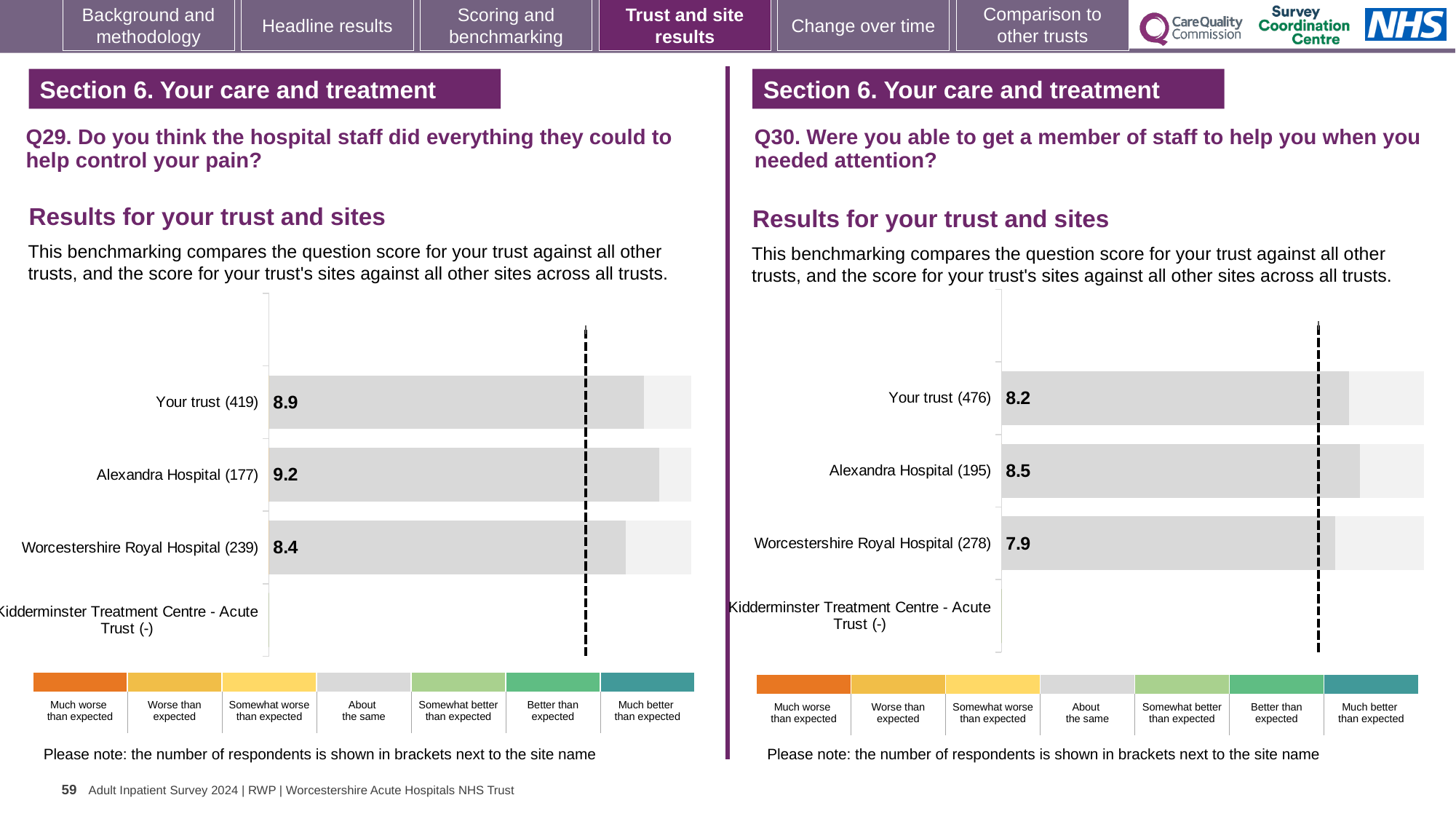
On the Q29 chart (left), what is the score for Your trust? 8.9 On the Q29 chart (left), what is the difference between the scores for Alexandra Hospital and Worcestershire Royal Hospital? 0.8 On the Q30 chart (right), how many respondents are shown in brackets for Your trust? 476 On the Q29 chart (left), what is the score for Worcestershire Royal Hospital? 8.4 On the Q30 chart (right), which site has the lowest score? Worcestershire Royal Hospital On the Q30 chart (right), what is the score for Worcestershire Royal Hospital? 7.9 On the Q30 chart (right), what is the score for Alexandra Hospital? 8.5 What kind of chart is used on the Q29 chart (left)? Bar chart On the Q29 chart (left), which site has the highest score? Alexandra Hospital On the Q30 chart (right), which is larger, the score for Your trust or for Worcestershire Royal Hospital? Your trust On the Q30 chart (right), what is the score for Your trust? 8.2 On the Q29 chart (left), what is the score for Alexandra Hospital? 9.2